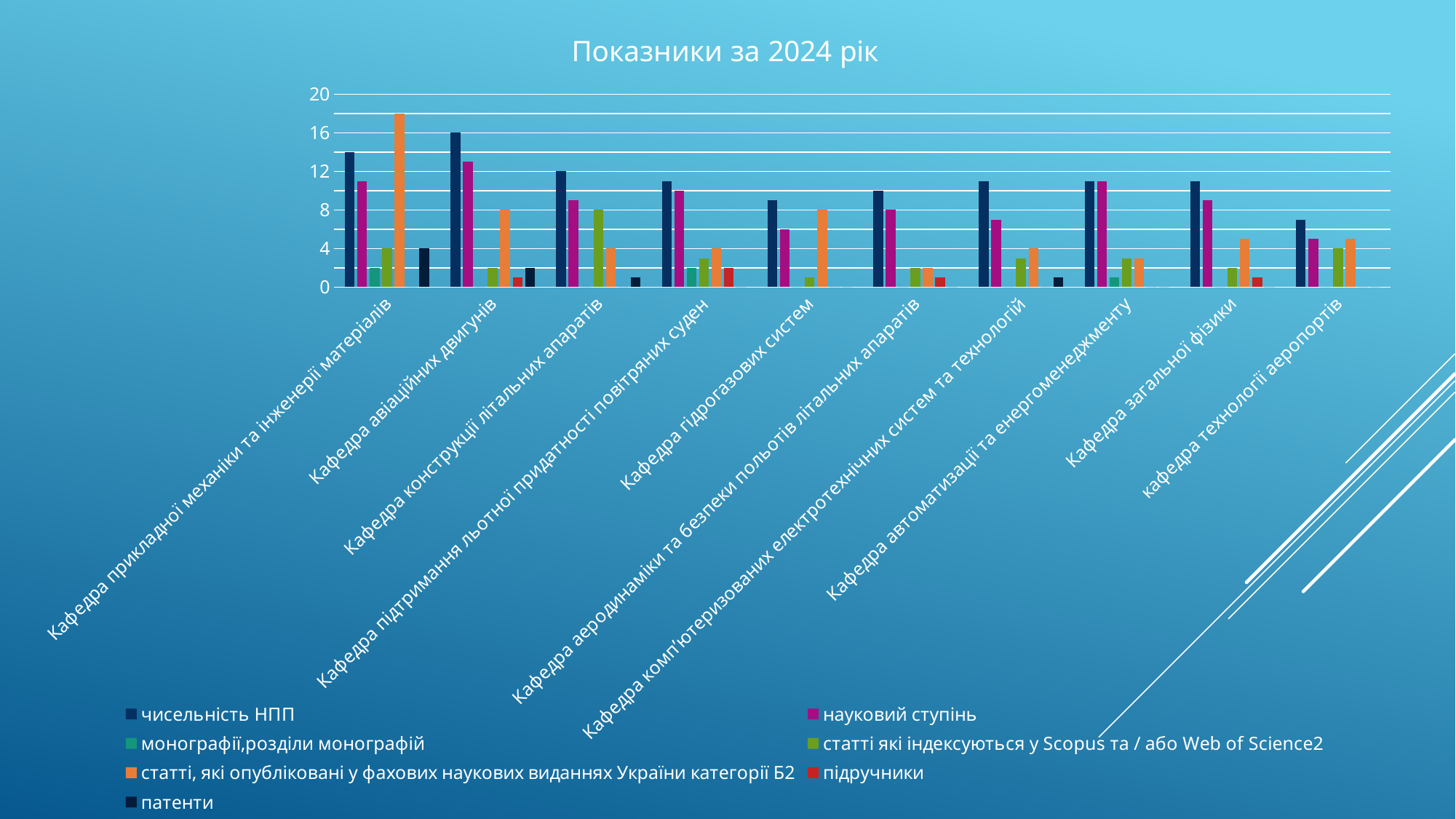
Is the value of чисельність НПП for Кафедра технології аеропортів greater or less than 8? less What is the value of статті які індексуються у Scopus та / або Web of Science2 for Кафедра конструкції літальних апаратів? 8 Is the value of статті, які опубліковані у фахових наукових виданнях України категорії Б2 for Кафедра прикладної механіки та інженерії матеріалів greater or less than 16? greater What is the value of чисельність НПП for Кафедра конструкції літальних апаратів? 12 Which department has the lowest value for чисельність НПП? Кафедра технології аеропортів Which is larger for Кафедра гідрогазових систем: чисельність НПП or науковий ступінь? чисельність НПП What kind of chart is shown on the slide? bar chart How many departments (categories) are shown on the x axis? 10 How many series does the legend list? 7 Which department has the highest value for чисельність НПП? Кафедра авіаційних двигунів What is the value of чисельність НПП for Кафедра авіаційних двигунів? 16 What is the title of the chart? Показники за 2024 рік